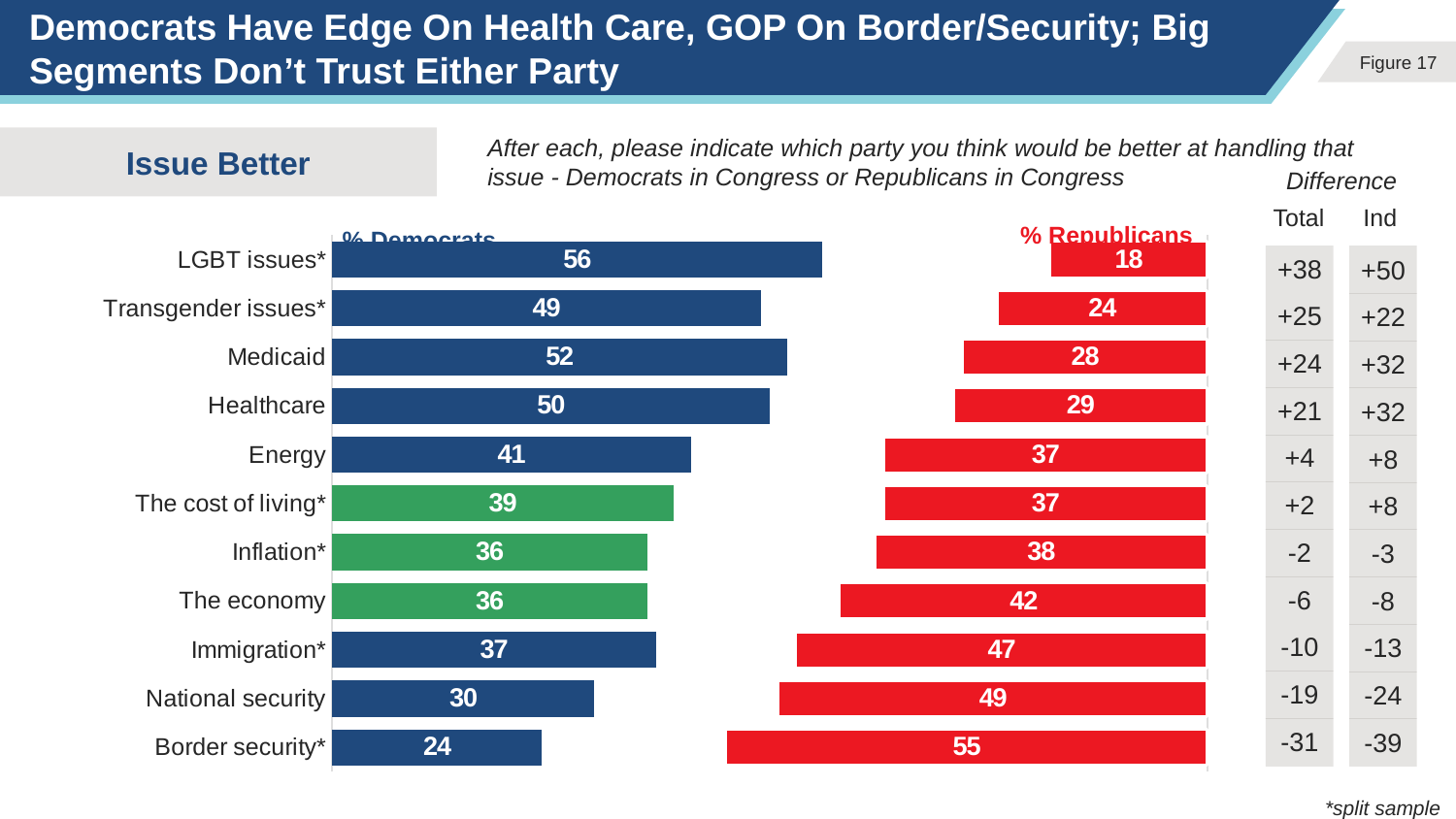
What kind of chart is shown on the slide? Bar chart Which issue has the highest % Democrats value? LGBT issues* What is the % Democrats value for Medicaid? 52 How many series does the chart show? 2 Do the % Republicans values rise or fall going from LGBT issues* at the top to Border security* at the bottom? Rise How many issues are listed in the chart? 11 What is the % Democrats value for Border security*? 24 Which issue has the lowest % Republicans value? LGBT issues* For Energy, which is larger: the % Democrats value or the % Republicans value? % Democrats For Healthcare, what is the difference between the % Democrats value and the % Republicans value? 21 Which issue has the highest % Republicans value? Border security* What is the % Republicans value for Immigration*? 47